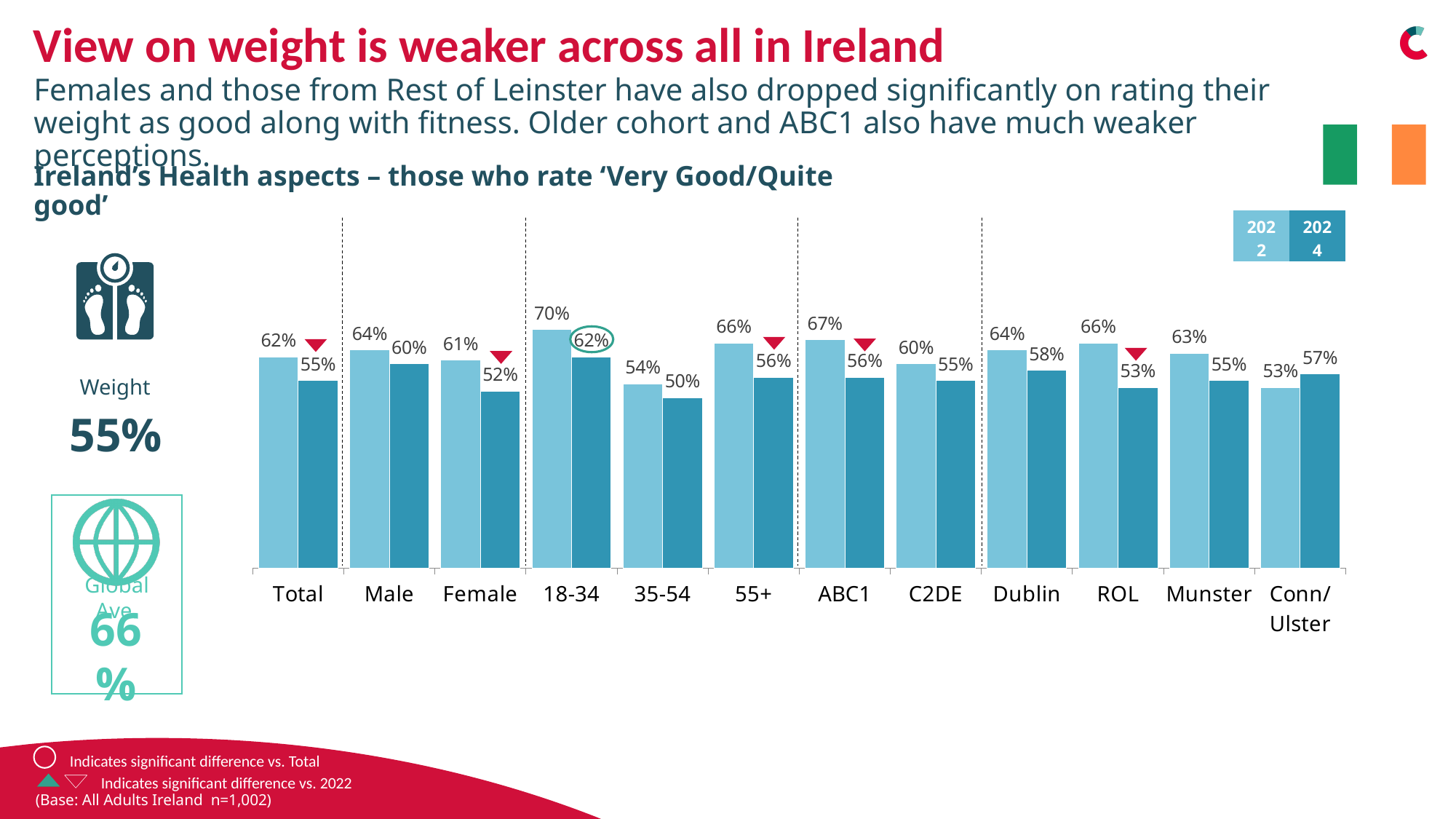
What is the difference between the 2022 and 2024 values for ROL? 13 percentage points How many categories are shown on the x axis? 12 What kind of chart is shown? Bar chart What is the 2022 value for ABC1? 67% What is the 2024 value for Dublin? 58% Which is larger for Conn/Ulster, the 2022 value or the 2024 value? 2024 Which category has the highest 2022 value? 18-34 Which years are listed in the legend? 2022 and 2024 What is the difference between the 2022 and 2024 values for Total? 7 percentage points What is the 2024 value for Female? 52% Which category has the lowest 2024 value? 35-54 How many series does the legend list? 2